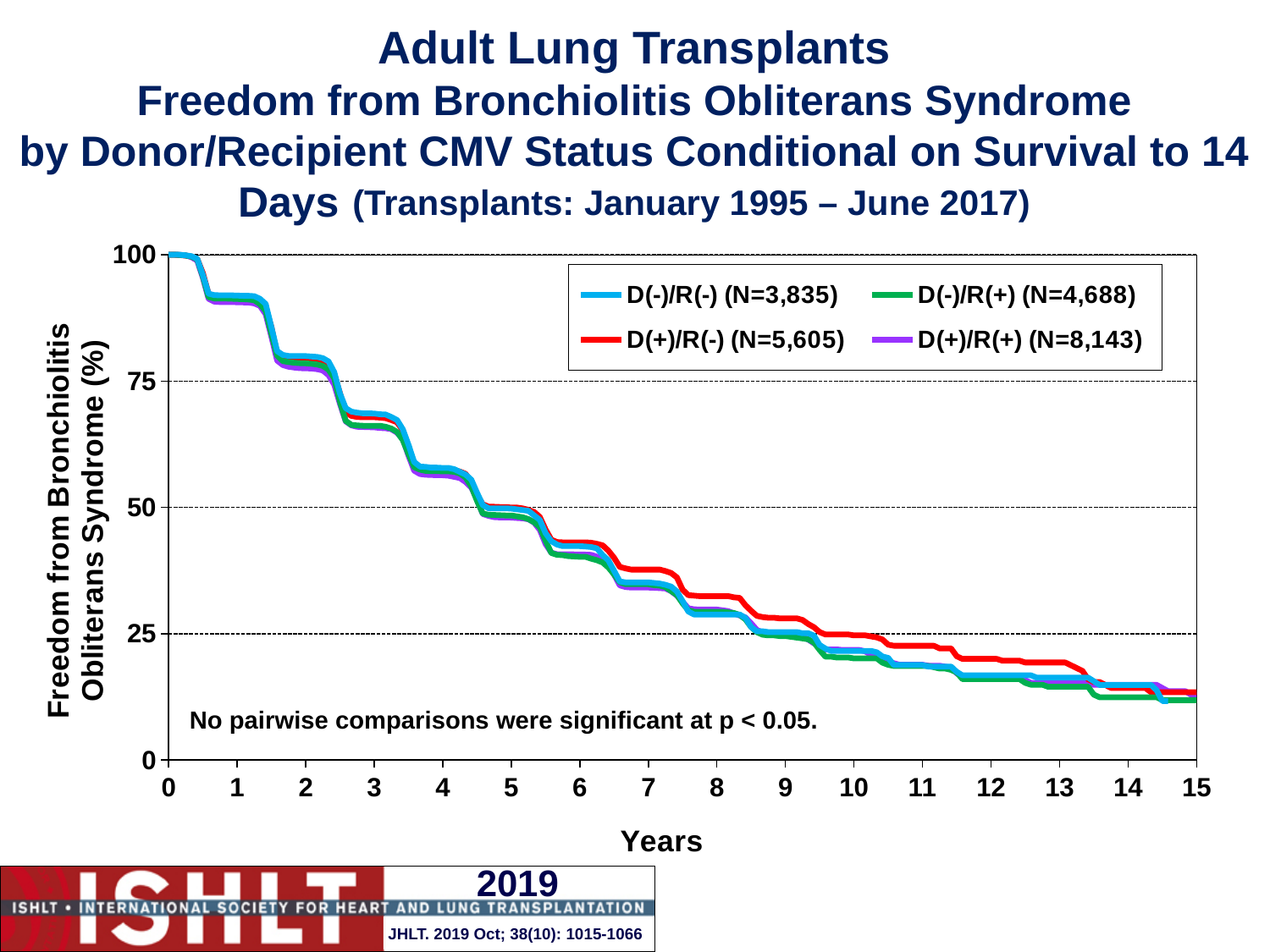
Do the curves rise or fall as the number of years increases? fall What kind of chart is shown on the slide? line chart Is the value for D(-)/R(-) at year 1 greater or less than 75? greater What is the label of the x axis? Years Is the value for D(+)/R(+) at year 7 greater or less than 50? less How many series does the legend list? 4 What is the maximum value shown on the x axis? 15 What is the sample size (N) shown in the legend for the D(+)/R(+) group? 8,143 Which series has the highest value at year 8? D(+)/R(-) (N=5,605) Is the value for D(-)/R(+) at year 12 greater or less than 25? less